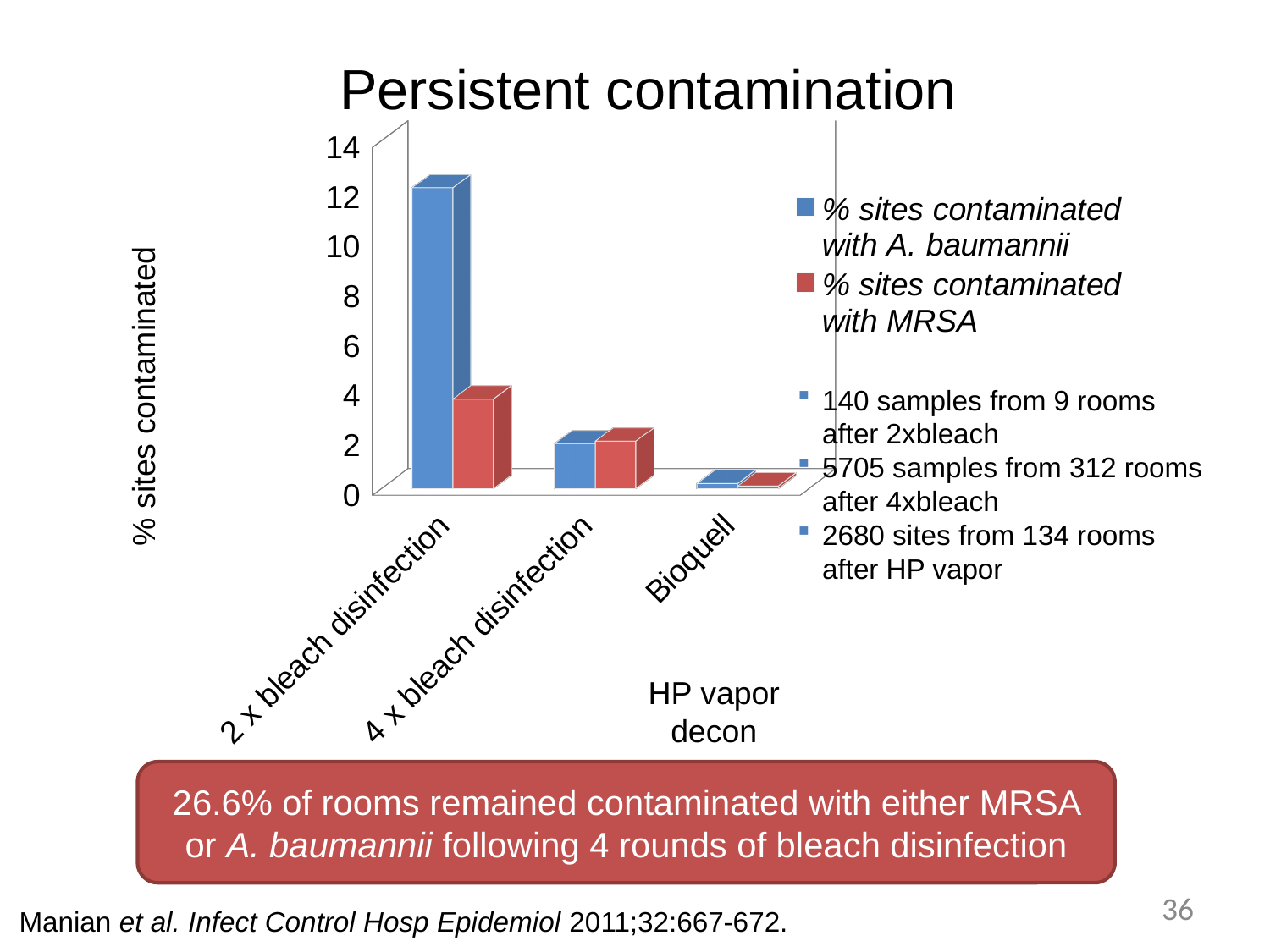
What kind of chart is shown on the slide? bar chart Is the value for % sites contaminated with MRSA after 2 x bleach disinfection greater or less than 6? less What is the title of the chart? Persistent contamination Is the value for % sites contaminated with A. baumannii after 2 x bleach disinfection greater or less than 10? greater What is the label on the vertical axis of the chart? % sites contaminated Which category has the highest value for % sites contaminated with A. baumannii? 2 x bleach disinfection Do the values for % sites contaminated with A. baumannii rise or fall from 2 x bleach disinfection to Bioquell? fall Is the value for % sites contaminated with A. baumannii after 4 x bleach disinfection greater or less than 4? less For 2 x bleach disinfection, which is larger: % sites contaminated with A. baumannii or % sites contaminated with MRSA? % sites contaminated with A. baumannii How many series does the legend list? 2 How many categories are shown on the x axis of the chart? 3 Which category has the lowest value for % sites contaminated with MRSA? Bioquell